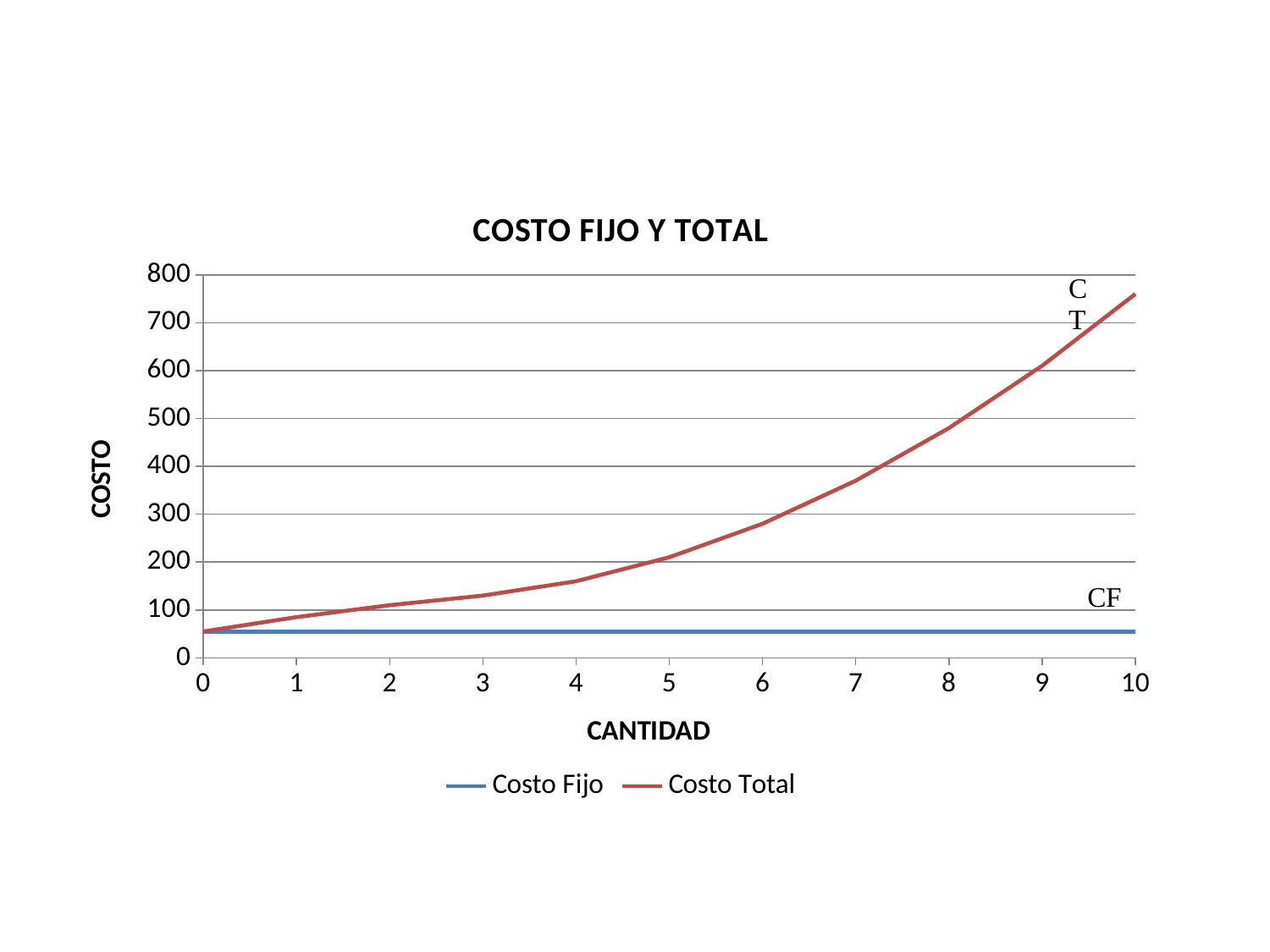
At CANTIDAD 8, which series has the higher value, Costo Fijo or Costo Total? Costo Total Is the value of Costo Total at CANTIDAD 10 greater or less than 700? greater Is the value of Costo Total at CANTIDAD 7 greater or less than 300? greater What is the label of the horizontal axis? CANTIDAD Which series reaches the highest value on the chart? Costo Total What kind of chart is shown on the slide? line chart Is the value of Costo Total at CANTIDAD 5 greater or less than 300? less Does the Costo Total series rise or fall as CANTIDAD increases from 0 to 10? rise What is the title of the chart? COSTO FIJO Y TOTAL How many series does the legend list? 2